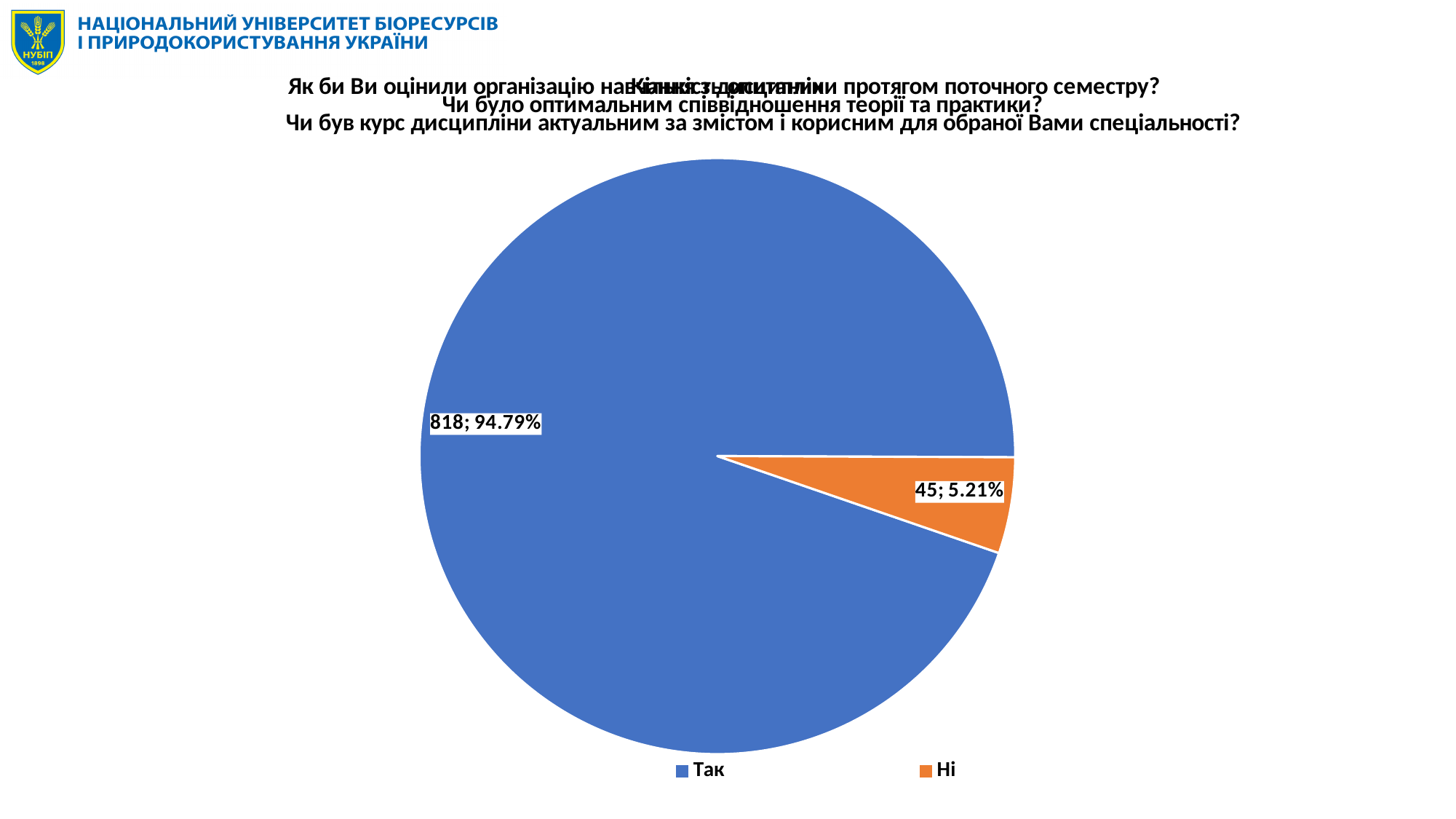
What percentage share does the "Ні" slice have? 5.21% What is the count shown for the "Так" slice? 818 What percentage share does the "Так" slice have? 94.79% What is the count shown for the "Ні" slice? 45 What is the difference between the counts for "Так" and "Ні"? 773 What kind of chart is shown on the slide? pie chart Which slice is the largest? Так How many slices does the pie chart have? 2 How many entries does the legend list? 2 What colour is the "Ні" slice? orange Which slice is the smallest? Ні Which has a larger count, "Так" or "Ні"? Так